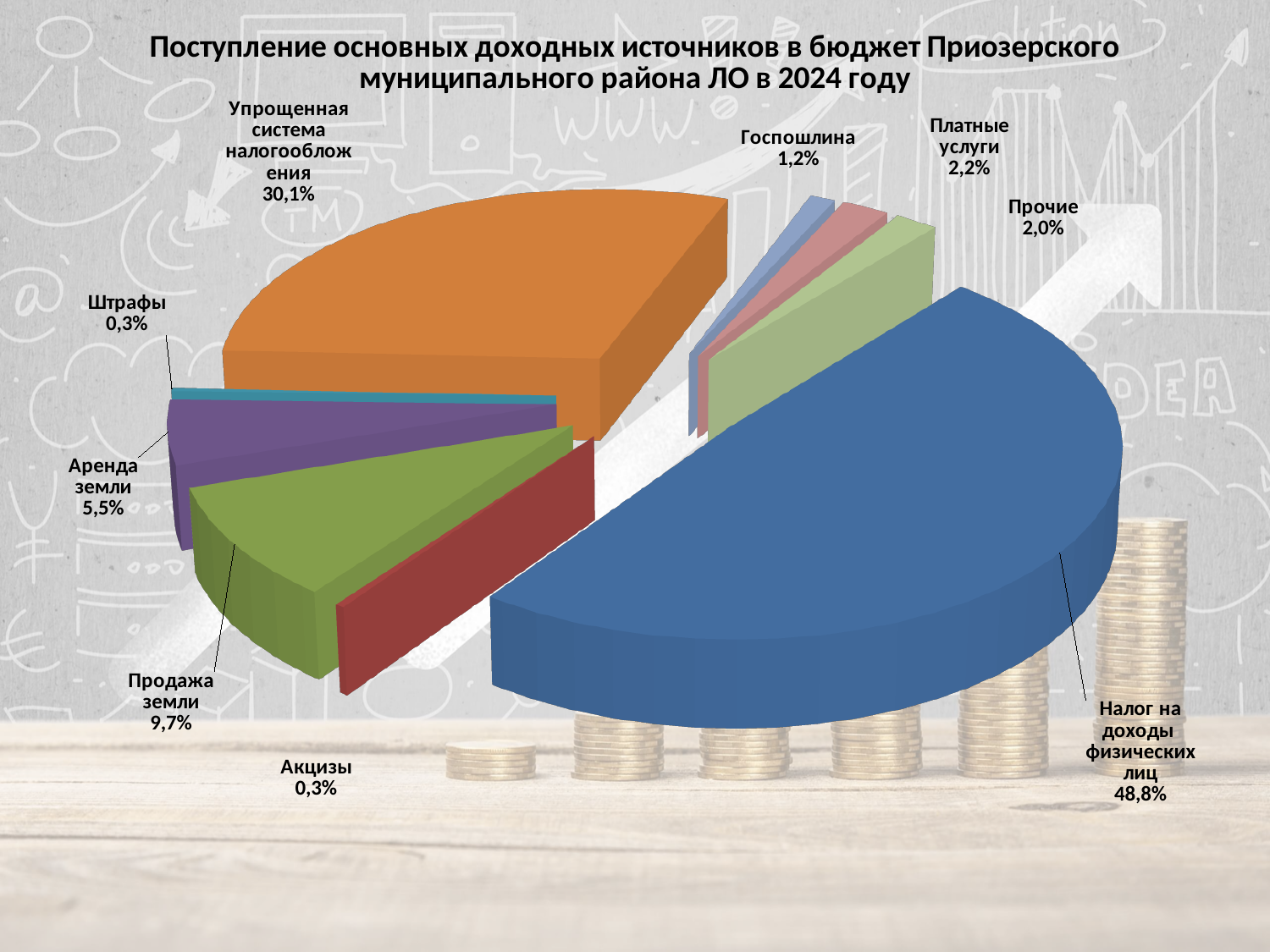
What is the value shown for Госпошлина? 1,2% What year does the chart title refer to? 2024 What is the value for Аренда земли? 5,5% What is the value shown for Упрощенная система налогообложения? 30,1% Which is larger: the share for Прочие or the share for Платные услуги? Платные услуги What percentage is shown for Платные услуги? 2,2% How many slices (revenue sources) does the pie chart show? 9 Which revenue source has the largest share of the pie? Налог на доходы физических лиц What share of the budget revenue comes from Налог на доходы физических лиц? 48,8% What is the difference between the shares of Налог на доходы физических лиц and Упрощенная система налогообложения? 18,7% What kind of chart is shown on the slide? Pie chart What percentage is shown for Продажа земли? 9,7%